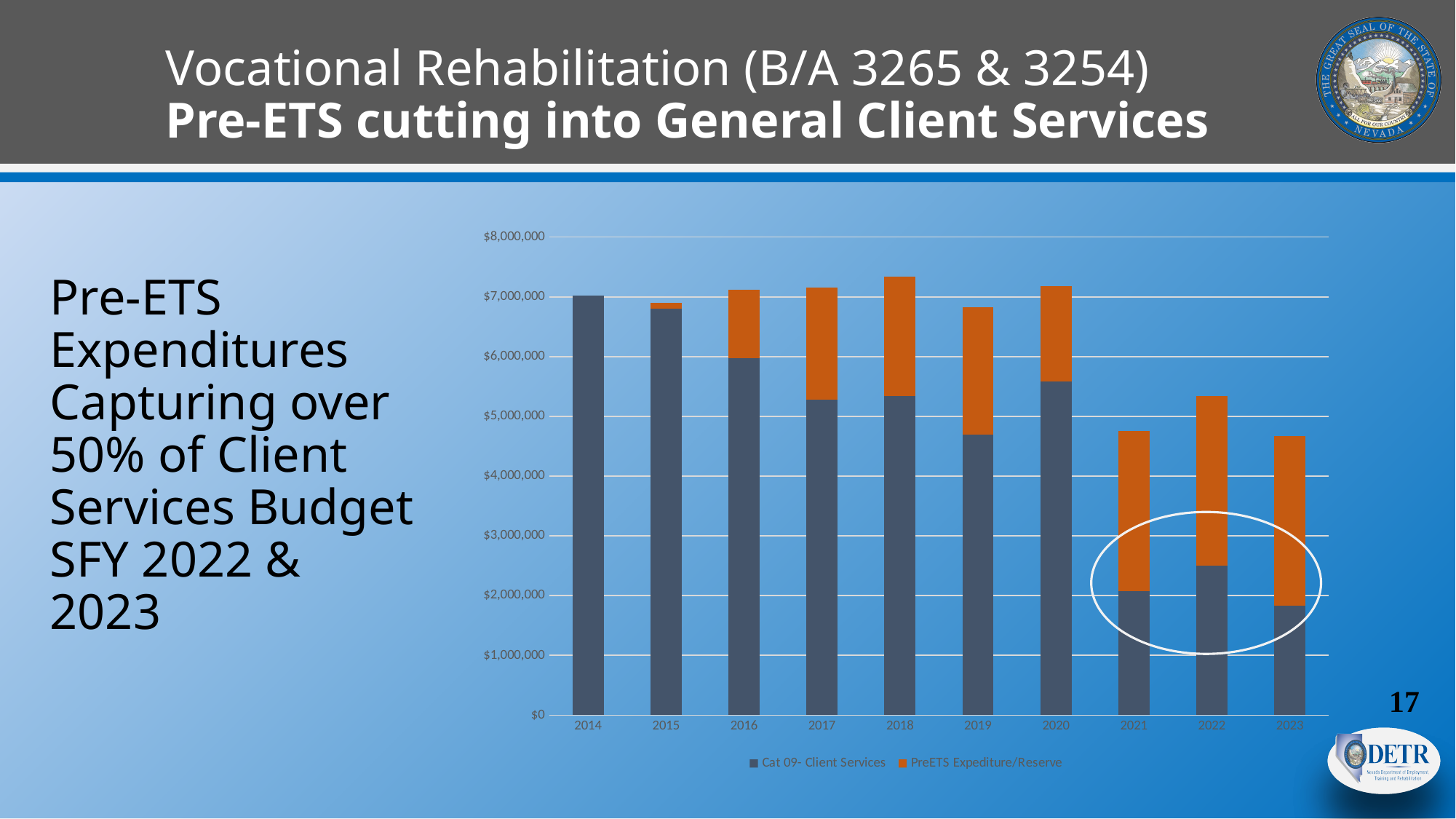
How many series does the chart's legend list? 2 Which is larger, the Cat 09- Client Services value for 2016 or for 2022? 2016 How many years are shown along the x axis of the chart? 10 Is the total stacked bar for 2021 greater or less than $5,000,000? less What kind of chart is shown on the slide? Stacked bar chart Which year has the highest Cat 09- Client Services value? 2014 Is the Cat 09- Client Services value for 2014 greater or less than $6,000,000? greater Is the total stacked bar for 2018 greater or less than $7,000,000? greater Does the Cat 09- Client Services value generally rise or fall from 2014 to 2023? fall Which year has the lowest Cat 09- Client Services value? 2023 Which series is shown in orange in the chart? PreETS Expediture/Reserve